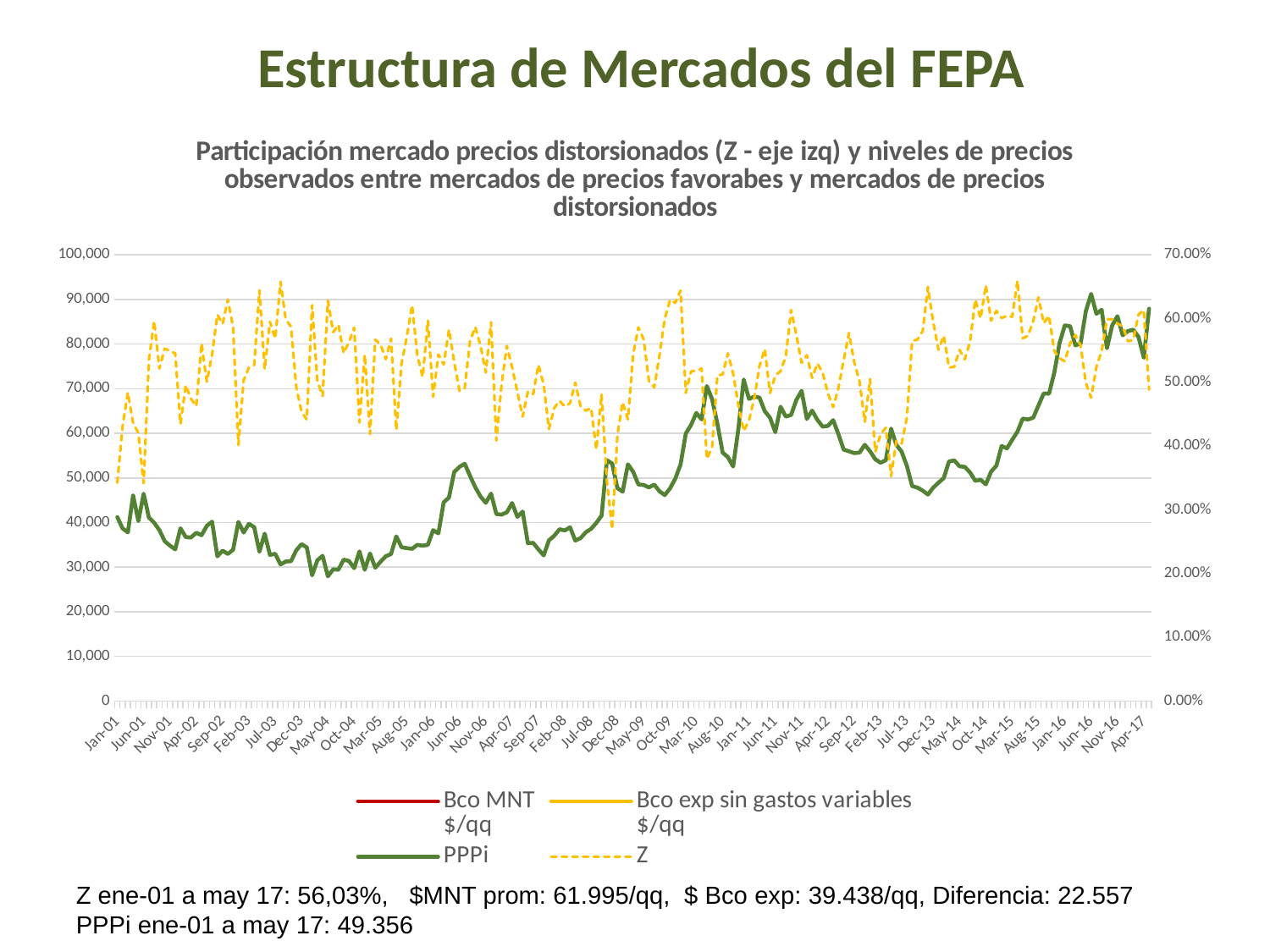
Does the PPPi series overall rise or fall between Jun-06 and Sep-07? fall Is the PPPi value at Jun-06 greater or less than 40,000? greater Which series in the legend is drawn with a dashed line? Z Is the PPPi value at Jun-16 greater or less than 80,000? greater What kind of chart is shown on the slide? line chart In which year does the PPPi series reach its lowest values? 2004 What is the highest value shown on the right-hand (percentage) axis? 70.00% Does the PPPi series overall rise or fall between Jan-16 and Apr-17? fall Is the PPPi value at Jan-01 greater or less than 30,000? greater How many series does the chart legend list? 4